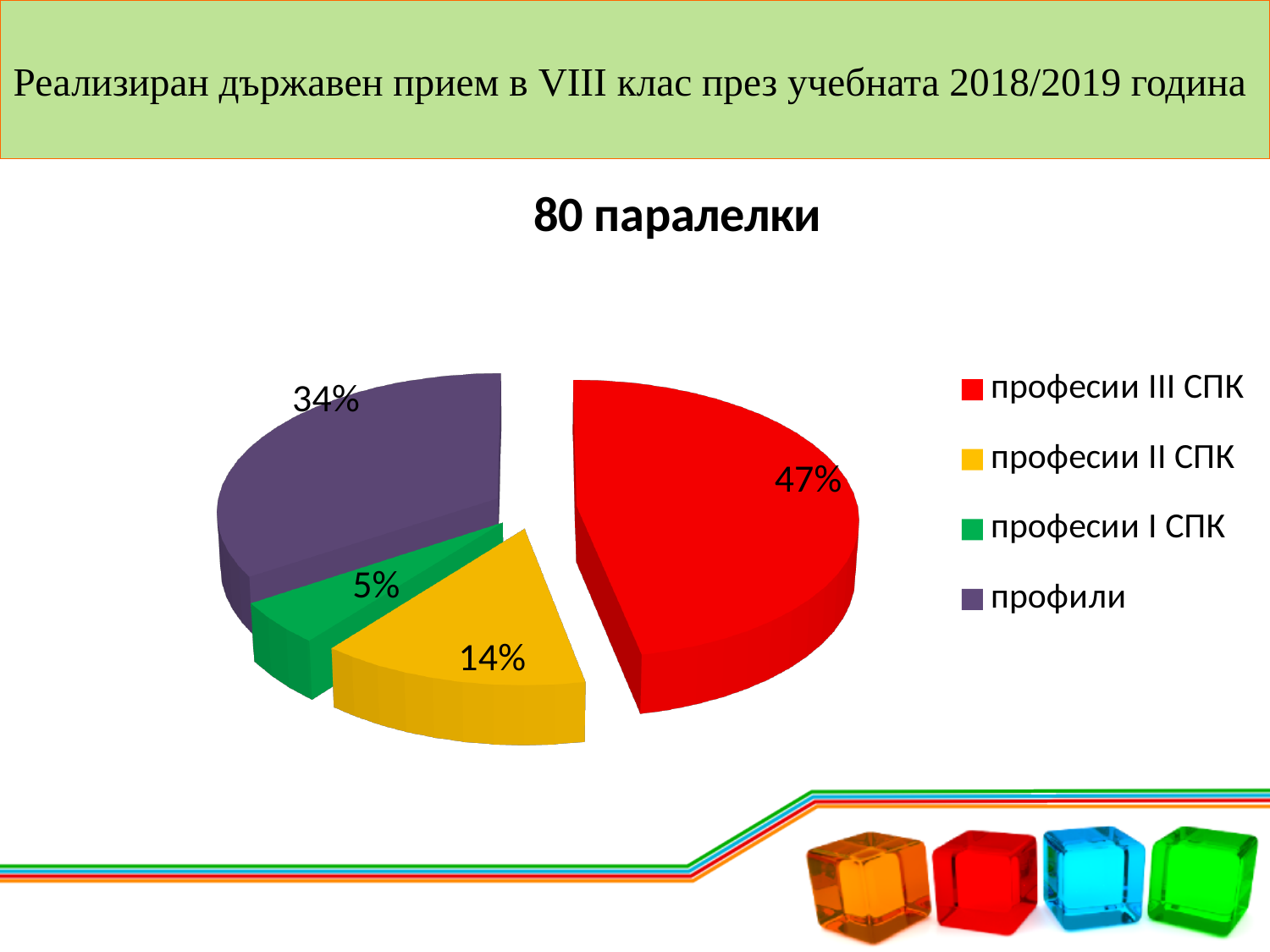
Which is larger, the share for професии II СПК or the share for професии I СПК? професии II СПК How many slices does the pie chart have? 4 What share of the pie does професии I СПК have? 5% What kind of chart is shown on the slide? pie chart What share of the pie does профили have? 34% What is the title of the chart? 80 паралелки What share of the pie does професии III СПК have? 47% Which category has the largest slice of the pie? професии III СПК What colour is the slice for профили? purple Which category has the smallest slice of the pie? професии I СПК What is the difference in percentage points between професии III СПК and профили? 13